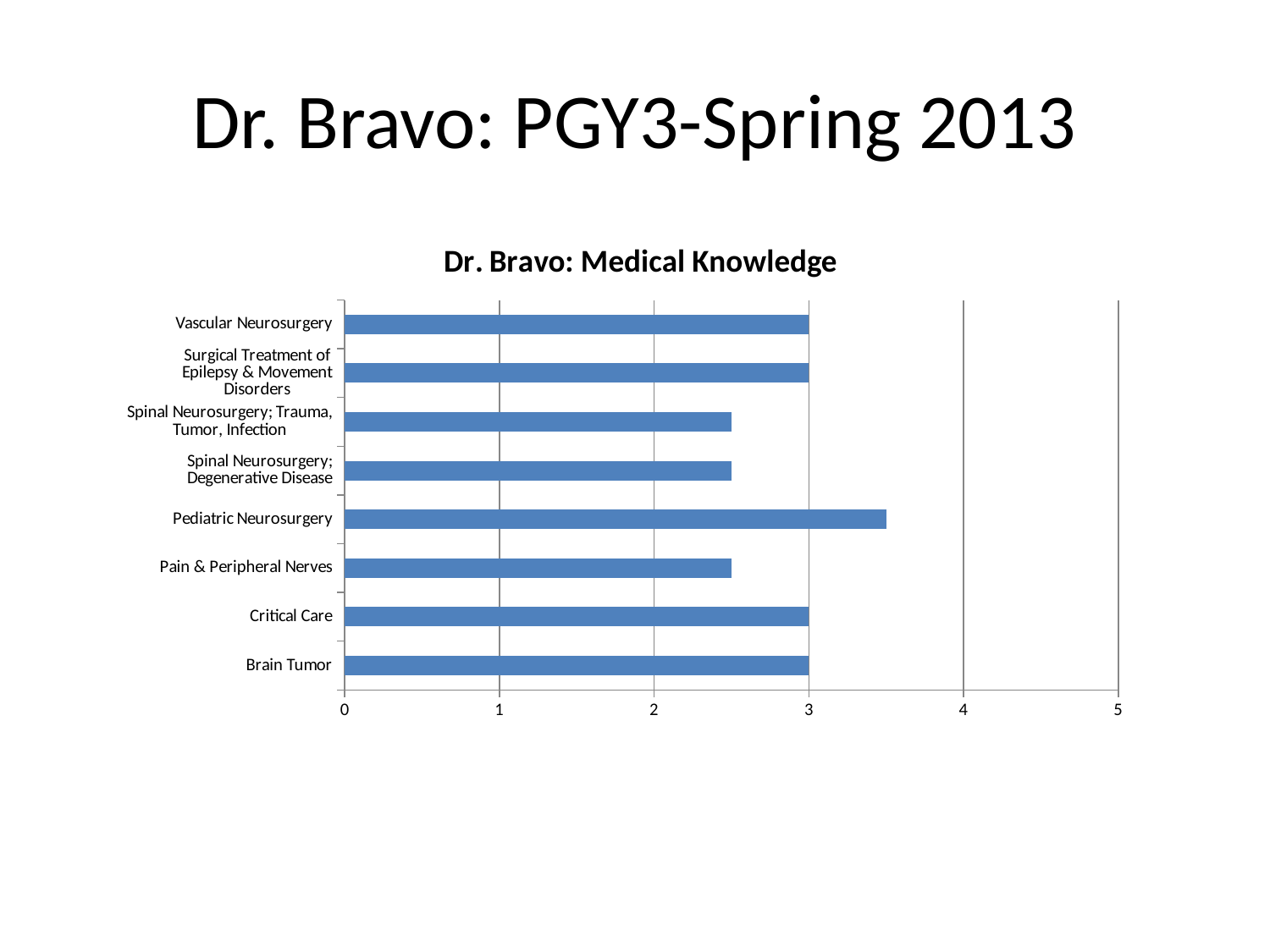
What is the title of the chart? Dr. Bravo: Medical Knowledge What is the value for Critical Care? 3 Is the value for Pediatric Neurosurgery greater or less than 3? greater Which is larger, the value for Pediatric Neurosurgery or the value for Critical Care? Pediatric Neurosurgery What is the value for Brain Tumor? 3 Which is larger, the value for Brain Tumor or the value for Pain & Peripheral Nerves? Brain Tumor Which category has the highest value? Pediatric Neurosurgery Is the value for Pain & Peripheral Nerves greater or less than 3? less Is the value for Spinal Neurosurgery; Degenerative Disease greater or less than 2? greater How many categories are plotted in the chart? 8 What is the value for Vascular Neurosurgery? 3 What type of chart is shown on the slide? bar chart